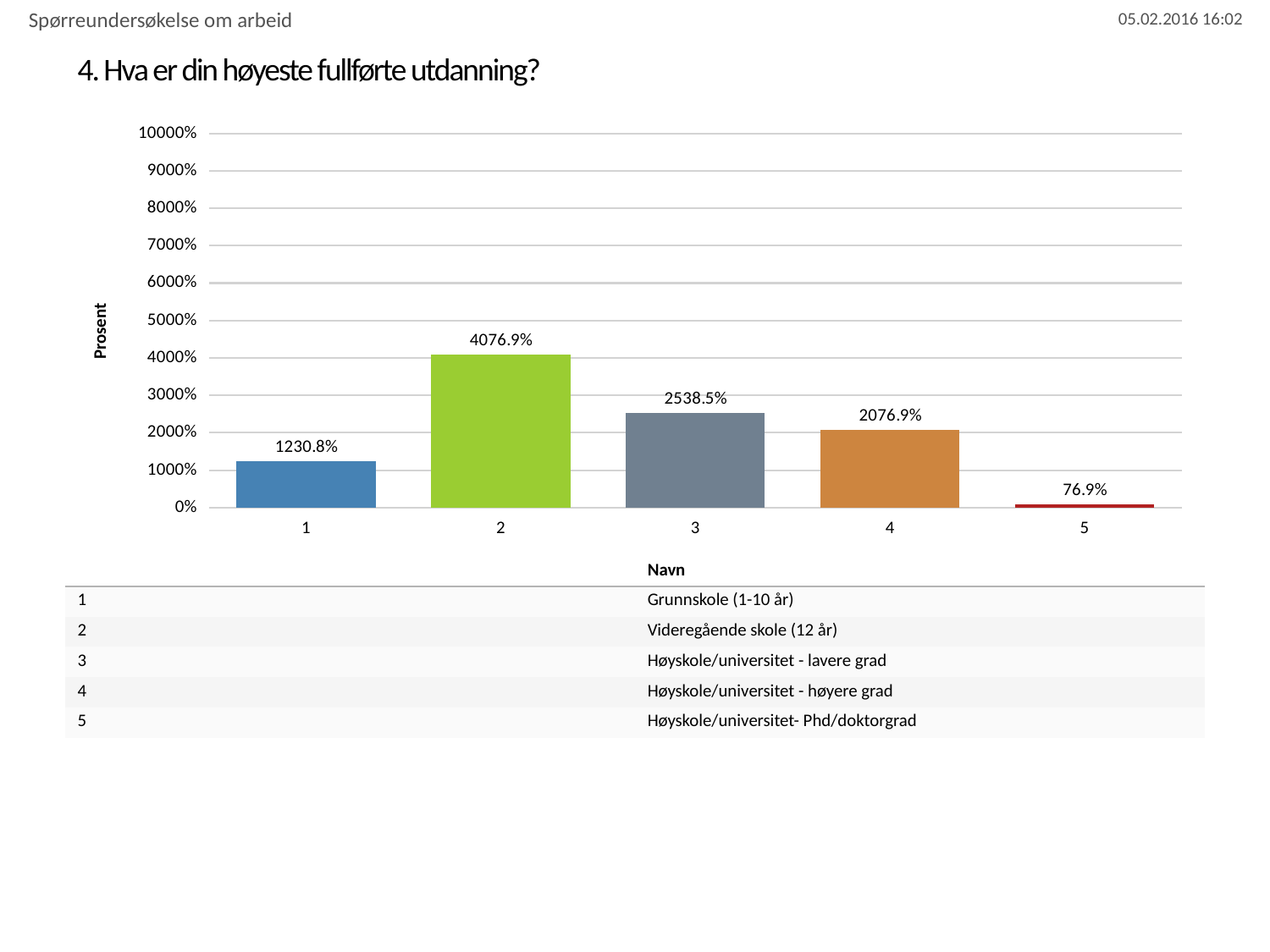
What is the value shown for category 2? 4076.9% What is the label of the y axis? Prosent What is the title of the chart? 4. Hva er din høyeste fullførte utdanning? What kind of chart is shown on the slide? bar chart What is the value shown for category 5? 76.9% What is the difference between the values for category 3 and category 4? 461.6% What is the value shown for category 1? 1230.8% Which category has the highest value? 2 Which has a larger value, category 1 or category 3? 3 Is the value for category 4 greater or less than 3000%? less How many categories are shown on the x axis? 5 Which category has the lowest value? 5